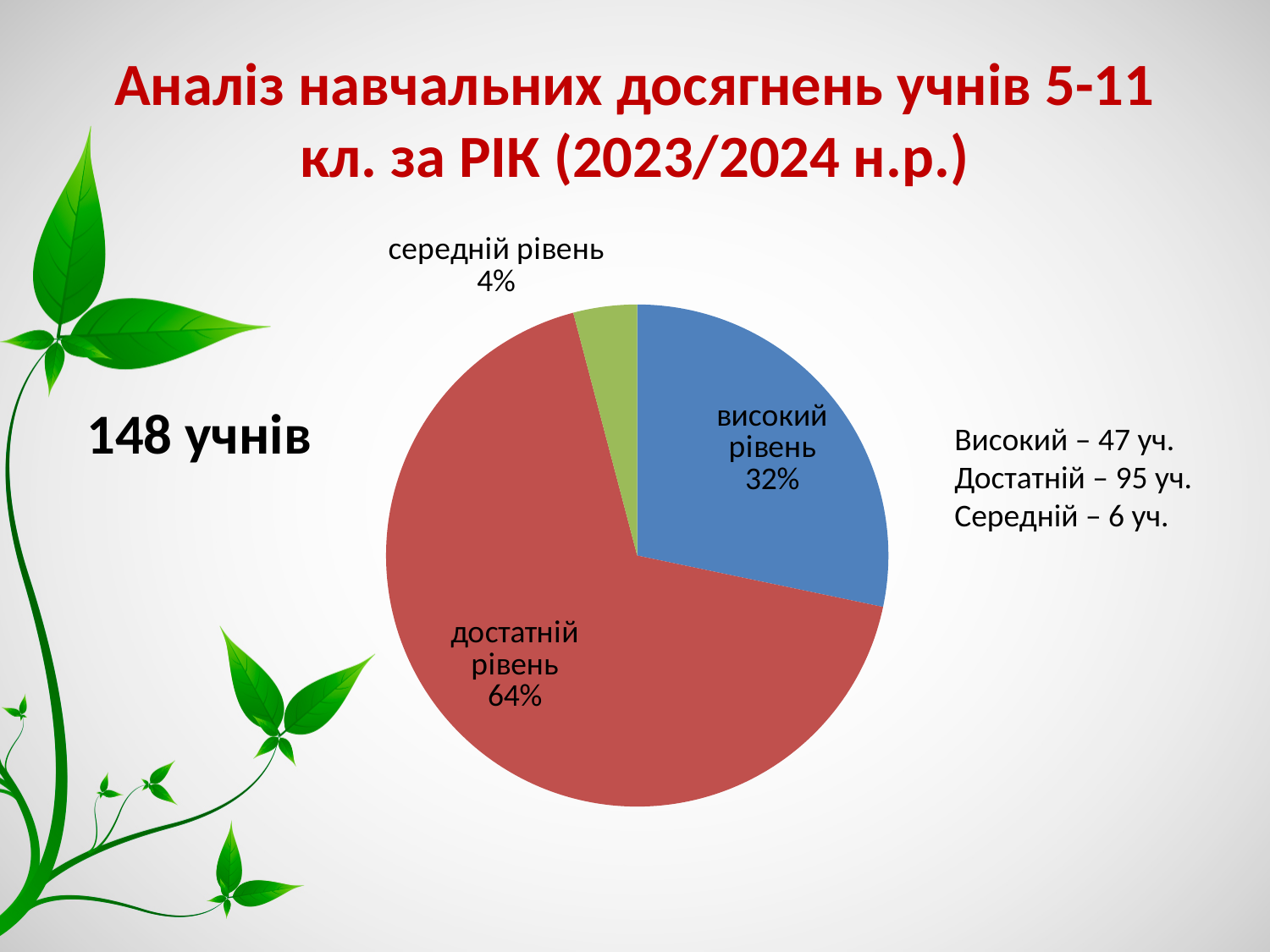
What kind of chart is shown on the slide? pie chart What colour is the "високий рівень" slice in the pie chart? blue Which slice of the pie chart is the smallest? середній рівень What share of the pie does the "середній рівень" slice represent? 4% How many slices does the pie chart have? 3 What share of the pie does the "високий рівень" slice represent? 32% What share of the pie does the "достатній рівень" slice represent? 64% Which slice is larger, "високий рівень" or "середній рівень"? високий рівень Which slice of the pie chart is the largest? достатній рівень What colour is the "достатній рівень" slice in the pie chart? red By how many percentage points does the "достатній рівень" slice exceed the "високий рівень" slice? 32 According to the text next to the chart, how many students are at the "Достатній" level? 95 уч.